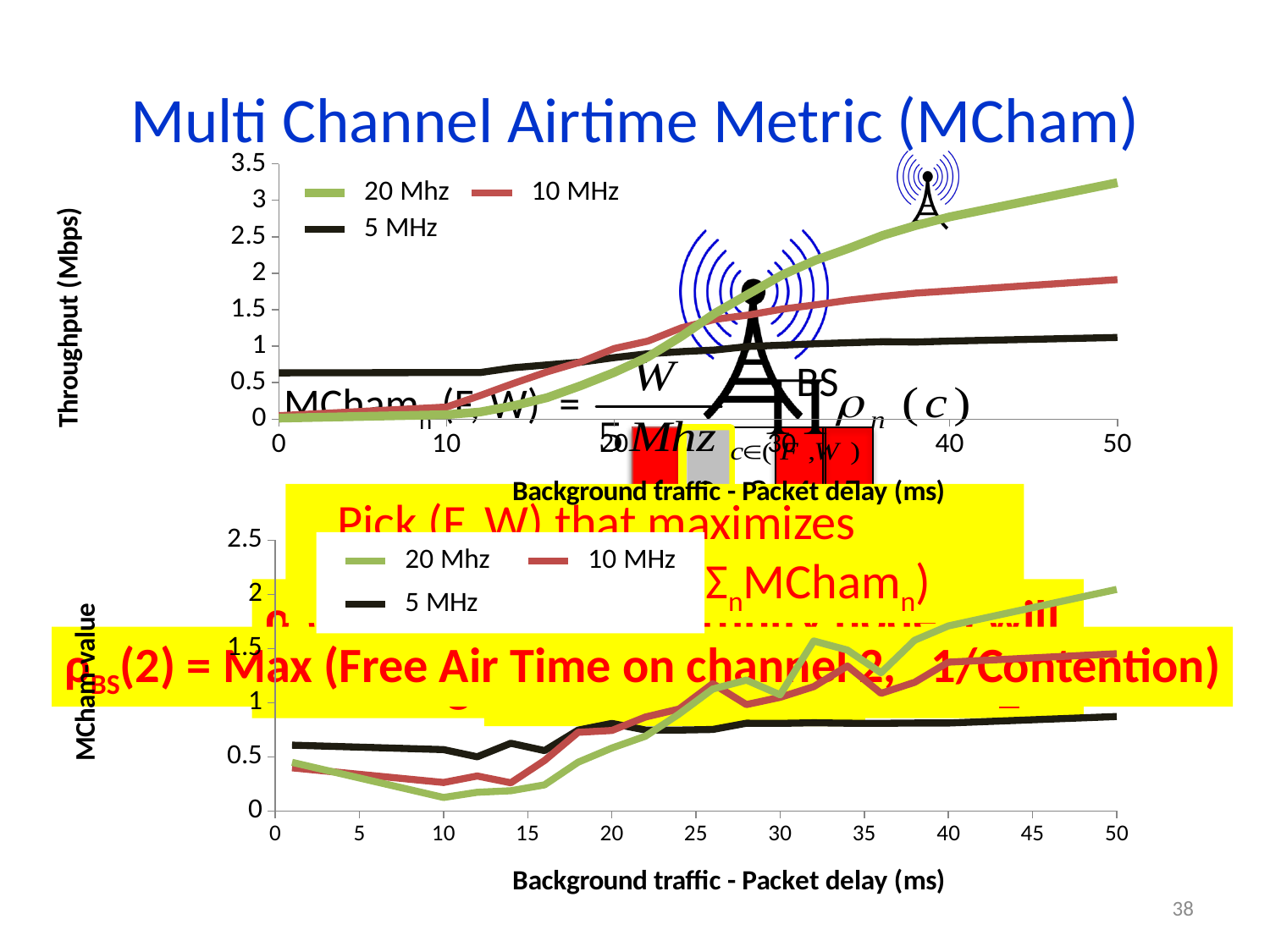
In the top chart (Throughput), which series has the highest value at 50 ms? 20 Mhz In the top chart (Throughput), is the value for 5 MHz at 0 ms greater or less than 1? less In the bottom chart (MCham-value), which series has the highest value at 50 ms? 20 Mhz What type of chart is the top chart (Throughput)? line chart In the top chart (Throughput), which series has the lowest value at 50 ms? 5 MHz In the top chart (Throughput), does the 20 Mhz series rise or fall as packet delay increases? rises In the top chart (Throughput), at 10 ms, which series is higher: 5 MHz or 20 Mhz? 5 MHz How many series does the legend of the top chart (Throughput) list? 3 In the top chart (Throughput), is the value for 20 Mhz at 50 ms greater or less than 3? greater What is the x-axis label of the bottom chart (MCham-value)? Background traffic - Packet delay (ms) In the bottom chart (MCham-value), is the value for 20 Mhz at 50 ms greater or less than 1.5? greater In the bottom chart (MCham-value), at 10 ms, which series is higher: 5 MHz or 20 Mhz? 5 MHz